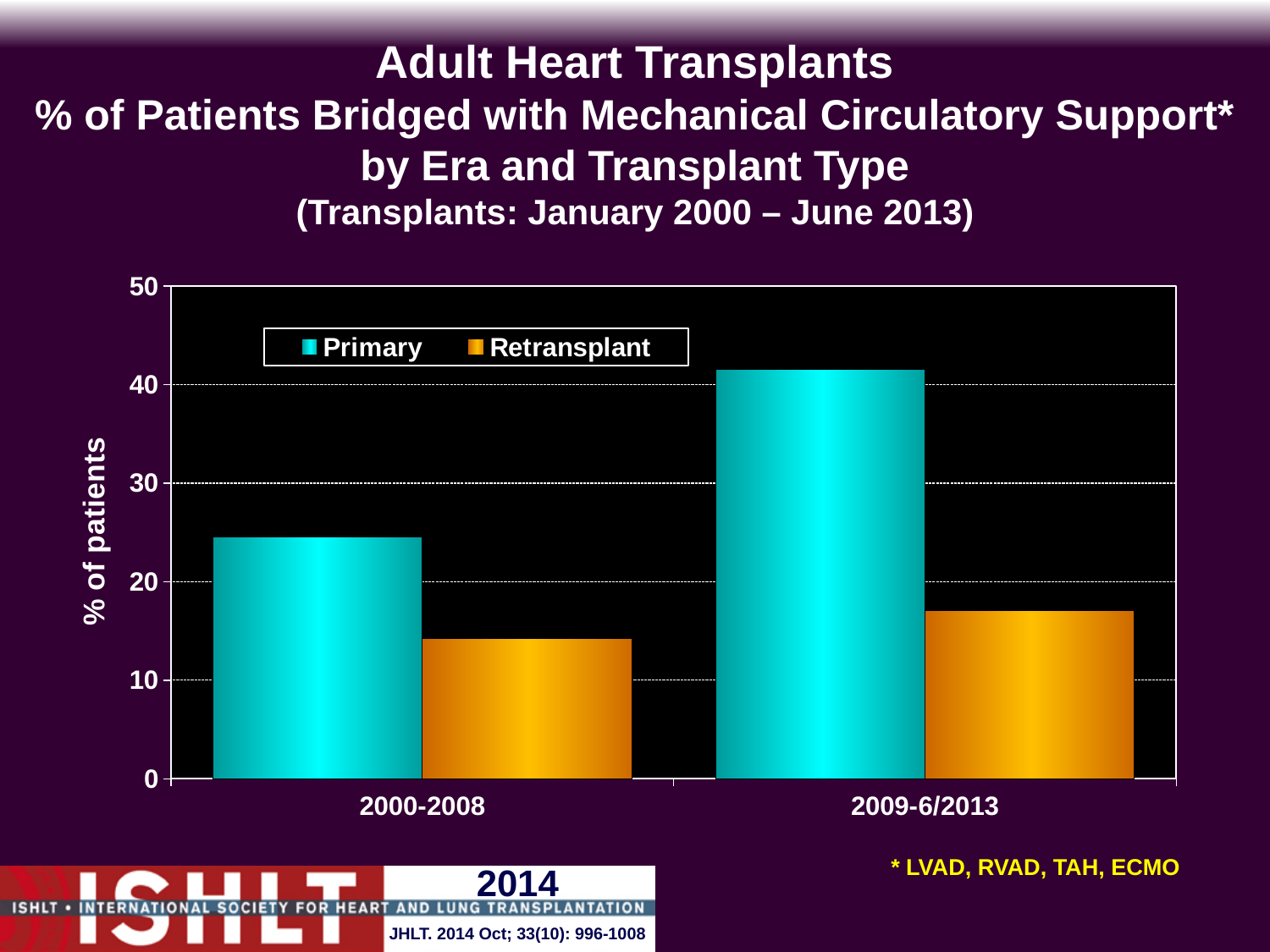
Does the Primary value rise or fall from 2000-2008 to 2009-6/2013? rise How many era categories are shown on the x axis? 2 Is the value for Retransplant in 2009-6/2013 greater or less than 20? less How many series does the legend list? 2 What kind of chart is shown on the slide? bar chart Which bar is the lowest on the chart? Retransplant, 2000-2008 Is the value for Retransplant in 2000-2008 greater or less than 20? less What is the label on the y axis? % of patients Which bar is the highest on the chart? Primary, 2009-6/2013 Is the value for Primary in 2009-6/2013 greater or less than 30? greater In 2009-6/2013, which is larger: Primary or Retransplant? Primary